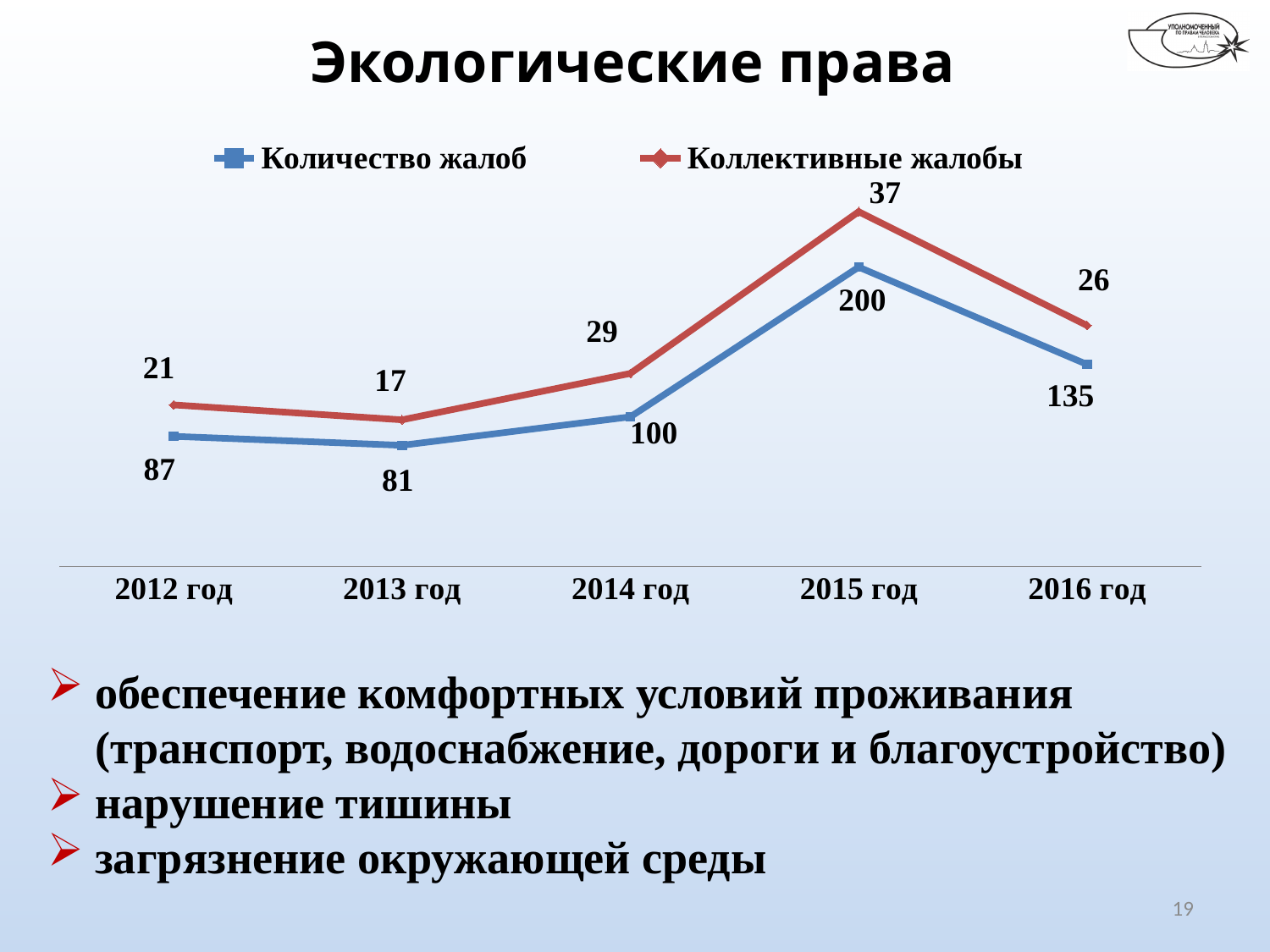
What is the value of "Количество жалоб" for 2015 год? 200 How many years are plotted along the x axis of the chart? 5 What is the difference between "Количество жалоб" in 2015 год and 2016 год? 65 Which is larger: "Коллективные жалобы" in 2014 год or in 2016 год? 2014 год In which year is "Количество жалоб" highest? 2015 год What type of chart is shown on the slide? line chart What is the title of the slide containing the chart? Экологические права In which year is "Коллективные жалобы" lowest? 2013 год How many series does the chart legend list? 2 What is the value of "Коллективные жалобы" for 2013 год? 17 Does "Количество жалоб" rise or fall from 2013 год to 2015 год? rise What is the value of "Количество жалоб" for 2016 год? 135